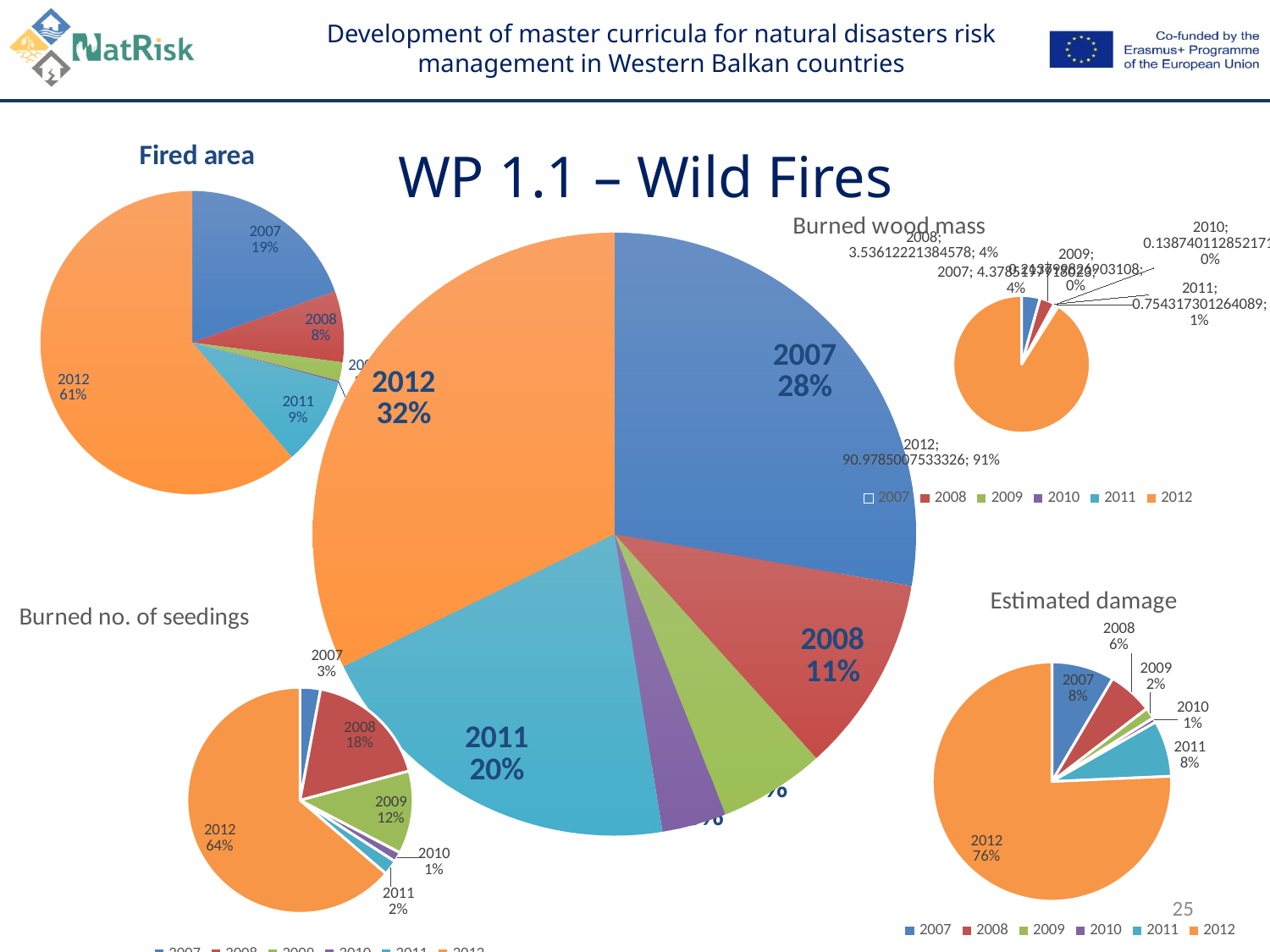
In the 'Estimated damage' pie chart, what share does 2012 have? 76% In the large central pie chart, what share does 2007 have? 28% In the 'Fired area' pie chart, which year has the largest slice? 2012 In the 'Burned wood mass' chart, how many entries does the legend list? 6 In the 'Burned wood mass' pie chart, what share does 2012 have? 91% What kind of chart is the large chart in the centre of the slide? Pie chart In the 'Burned no. of seedings' pie chart, what is the difference in percentage points between the 2012 and 2008 shares? 46 percentage points In the 'Fired area' pie chart, what is the difference in percentage points between the 2007 and 2008 shares? 11 percentage points In the 'Burned no. of seedings' pie chart, which year has the smallest slice? 2010 In the 'Estimated damage' pie chart, which slice is larger, 2008 or 2009? 2008